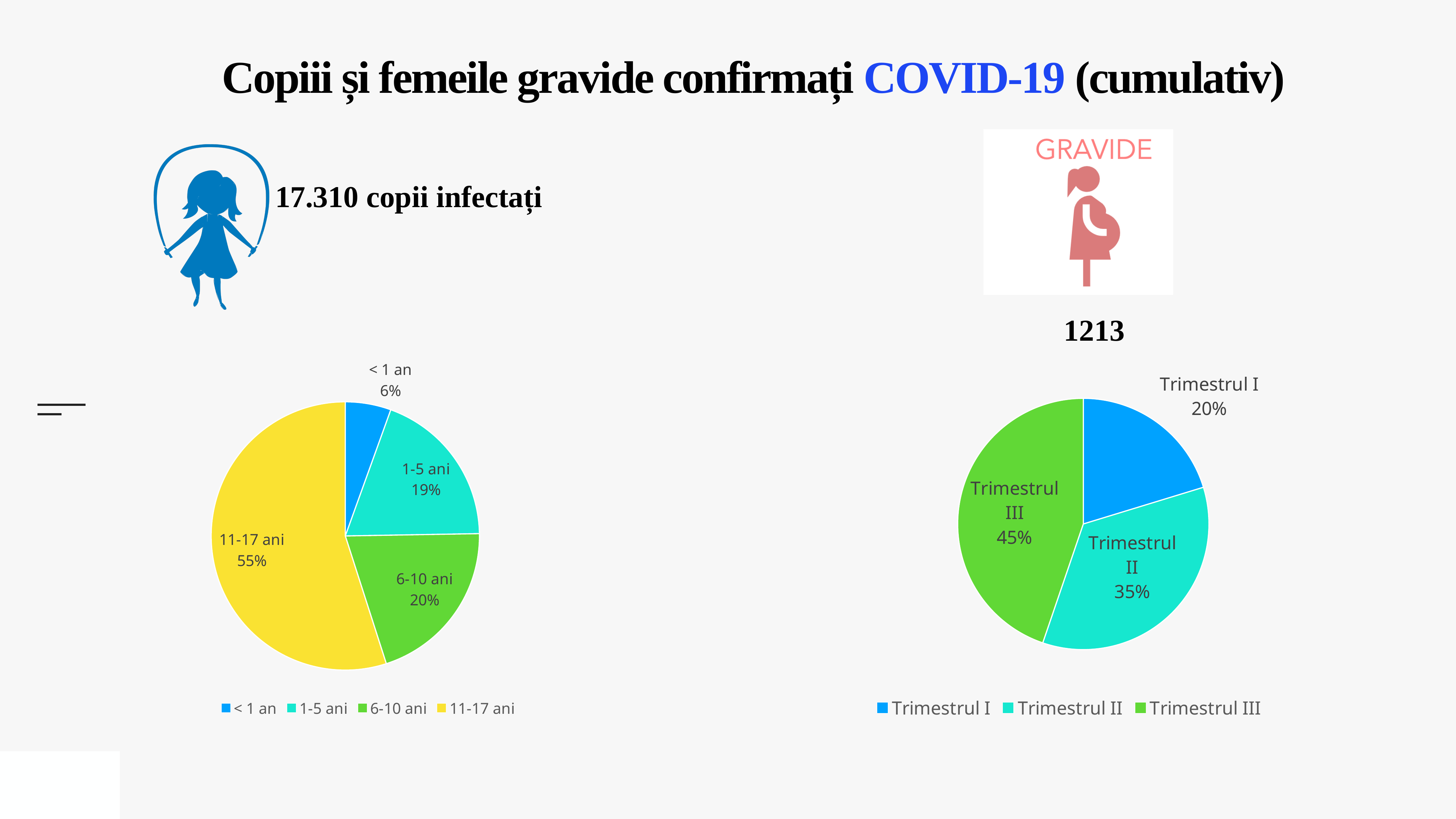
In the right pie chart (pregnant women by trimester), which trimester has the largest share? Trimestrul III In the left pie chart (children by age), what share is labelled for the 11-17 ani slice? 55% In the right pie chart (pregnant women by trimester), how many entries does the legend list? 3 What type of chart is shown on the right side of the slide? Pie chart In the left pie chart (children by age), which age group has the smallest share? < 1 an In the left pie chart (children by age), how many slices does the pie have? 4 In the left pie chart (children by age), what share is labelled for the < 1 an slice? 6% In the right pie chart (pregnant women by trimester), which is larger, Trimestrul I or Trimestrul II? Trimestrul II In the left pie chart (children by age), which age group has the largest share? 11-17 ani In the left pie chart (children by age), what is the difference in percentage points between the 11-17 ani and 1-5 ani slices? 36 In the right pie chart (pregnant women by trimester), what share is labelled for Trimestrul II? 35% What total number of infected children is stated on the slide? 17.310